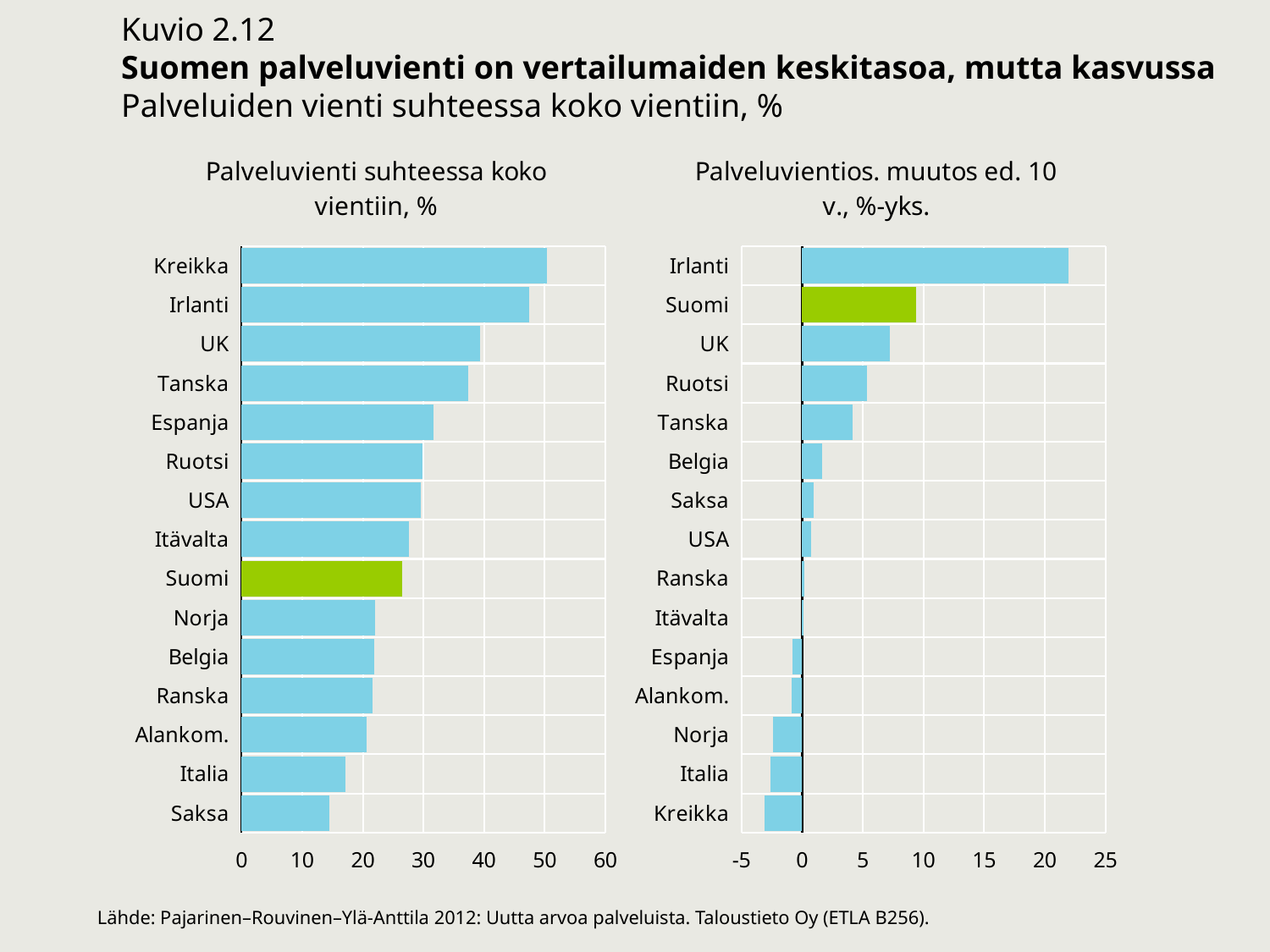
In the right chart (Palveluvientios. muutos ed. 10 v., %-yks.), is the value for Suomi greater or less than 5? greater What type of chart is the right chart (Palveluvientios. muutos ed. 10 v., %-yks.)? Bar chart In the left chart (Palveluvienti suhteessa koko vientiin, %), is the value for Kreikka greater or less than 40? greater In the right chart (Palveluvientios. muutos ed. 10 v., %-yks.), which country has the highest value? Irlanti In the right chart (Palveluvientios. muutos ed. 10 v., %-yks.), which country has the lowest value? Kreikka How many countries are shown in the left chart (Palveluvienti suhteessa koko vientiin, %)? 15 In the left chart (Palveluvienti suhteessa koko vientiin, %), is the value for Suomi greater or less than 30? less In the left chart (Palveluvienti suhteessa koko vientiin, %), which country has the highest value? Kreikka In the left chart (Palveluvienti suhteessa koko vientiin, %), which is larger, the value for Irlanti or the value for UK? Irlanti In the left chart (Palveluvienti suhteessa koko vientiin, %), which country has the lowest value? Saksa In the right chart (Palveluvientios. muutos ed. 10 v., %-yks.), which is larger, the value for Suomi or the value for Ruotsi? Suomi